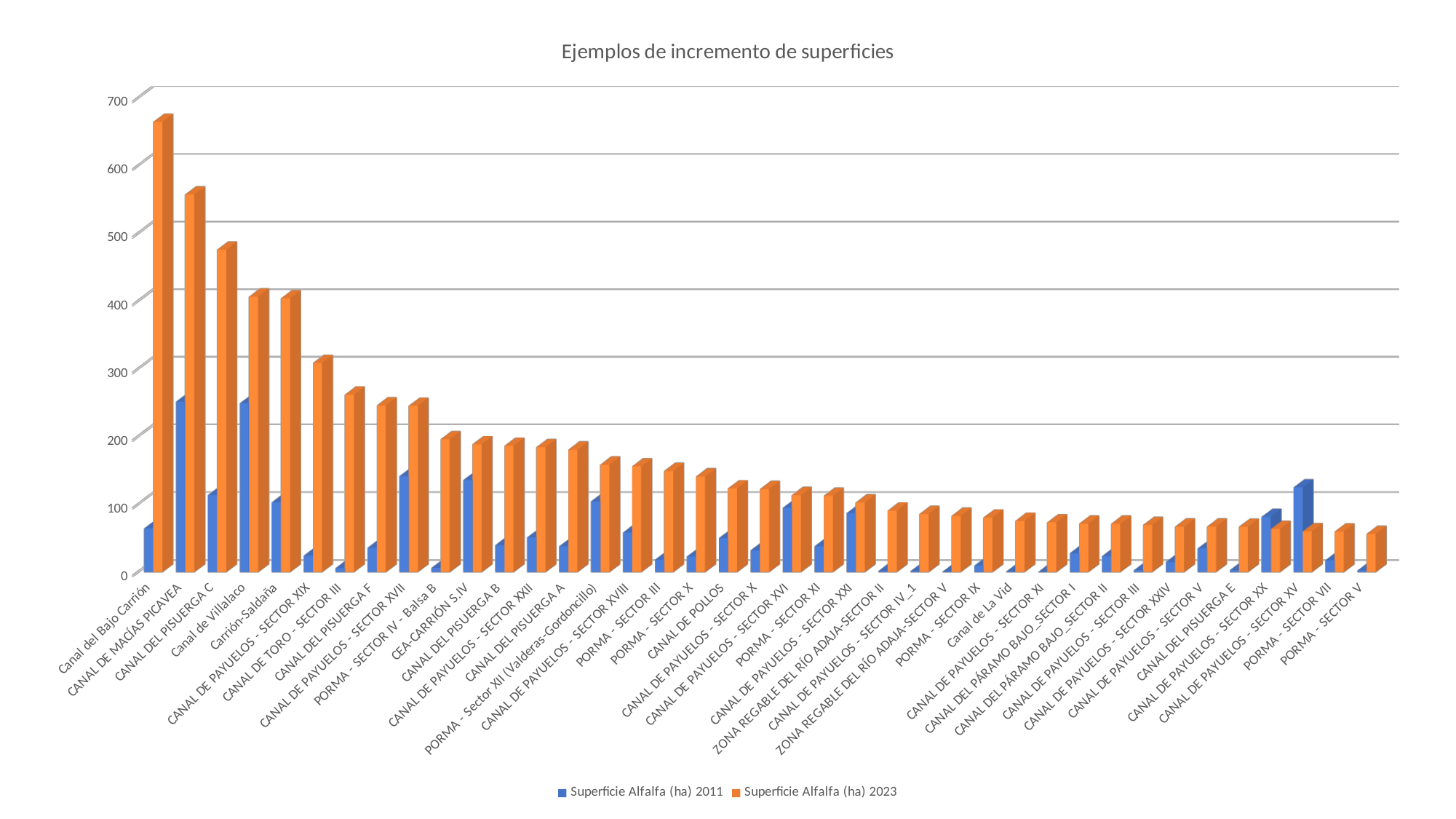
For CANAL DE PAYUELOS - SECTOR XV, which is larger: the 2011 value or the 2023 value? 2011 Which is larger for Superficie Alfalfa (ha) 2023: Canal del Bajo Carrión or CANAL DE MACÍAS PICAVEA? Canal del Bajo Carrión Which category has the highest value for Superficie Alfalfa (ha) 2023? Canal del Bajo Carrión How many series does the legend list? 2 Is the Superficie Alfalfa (ha) 2023 value for CANAL DE TORO - SECTOR III greater or less than 200? greater Do the Superficie Alfalfa (ha) 2023 values generally rise or fall from left to right along the x axis? Fall What kind of chart is shown on the slide? Bar chart What is the title of the chart? Ejemplos de incremento de superficies Is the Superficie Alfalfa (ha) 2023 value for CANAL DEL PISUERGA C greater or less than 500? less Is the Superficie Alfalfa (ha) 2023 value for Canal del Bajo Carrión greater or less than 600? greater Which series is shown in orange? Superficie Alfalfa (ha) 2023